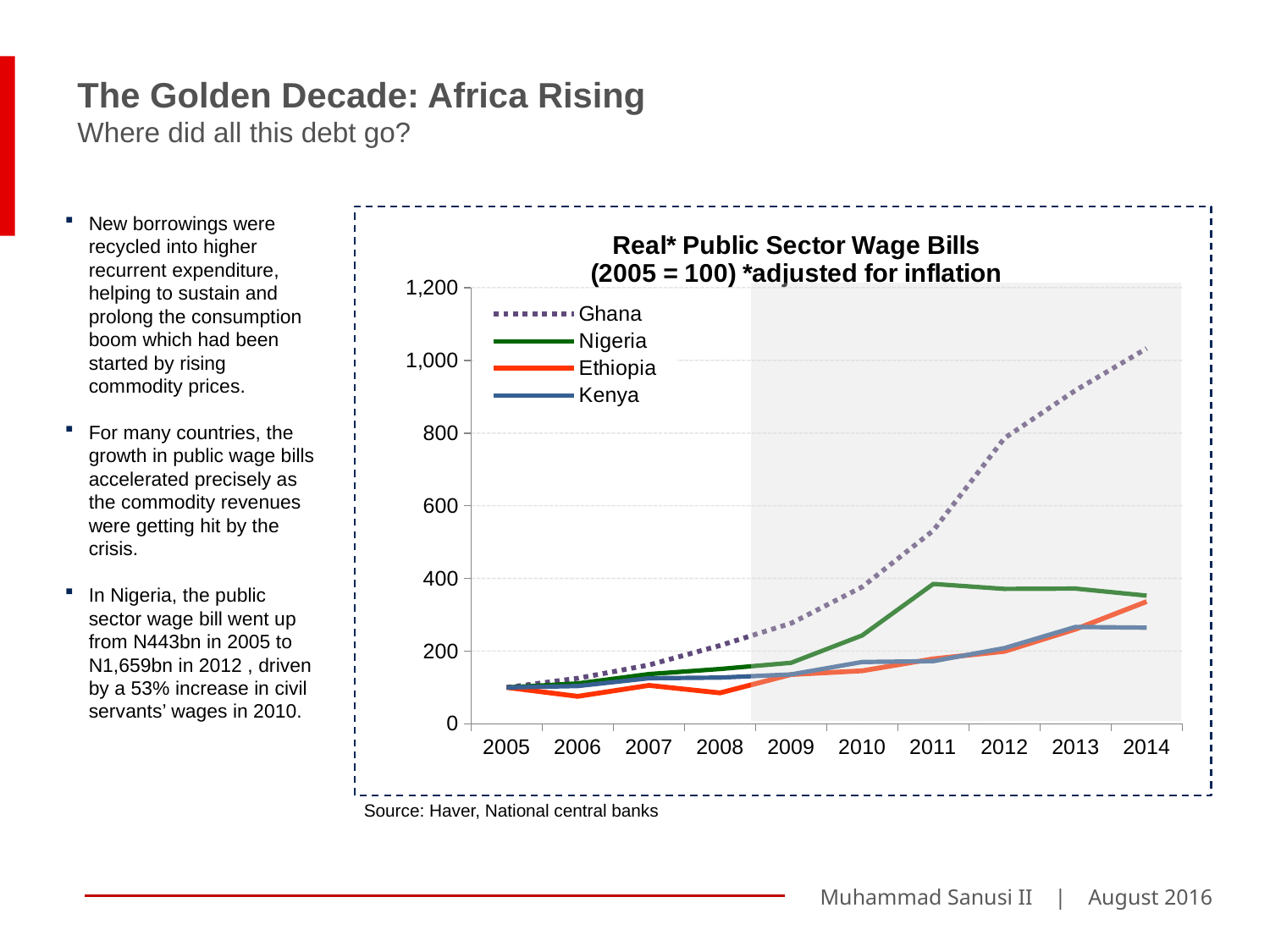
How many series does the legend list? 4 Is the value for Kenya in 2014 greater or less than 400? less Is the value for Ghana in 2011 greater or less than 400? greater Which country has the highest real public sector wage bill index in 2014? Ghana How many years are shown on the x axis? 10 Is the value for Nigeria in 2011 greater or less than 200? greater In 2011, which is larger: the value for Nigeria or the value for Ethiopia? Nigeria Which country has the lowest real public sector wage bill index in 2014? Kenya What kind of chart is shown on the slide? line chart Does the Ghana series rise or fall from 2005 to 2014? rise Which series is drawn with a dotted line? Ghana